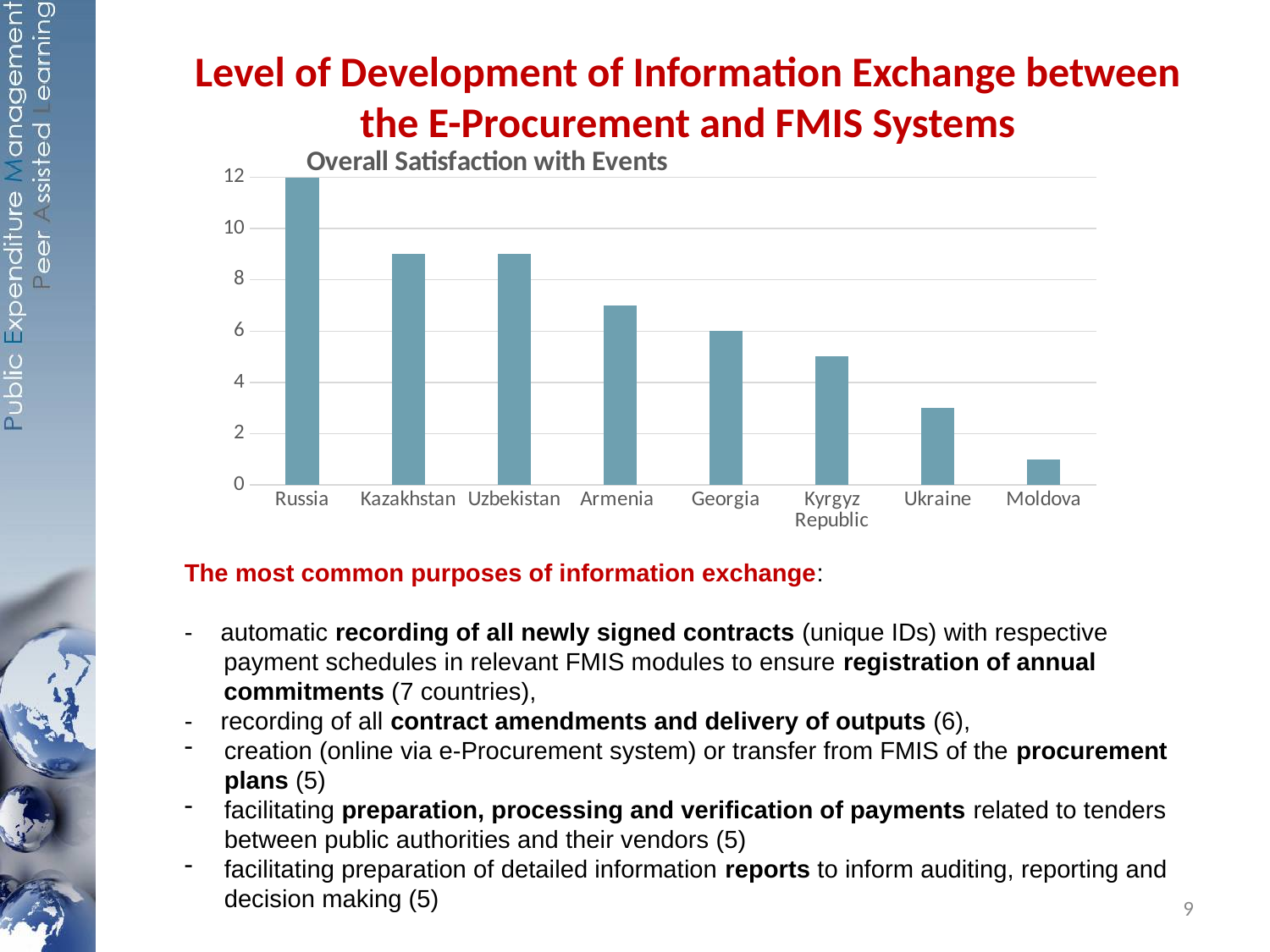
What type of chart is shown on the slide? bar chart Do the values rise or fall moving from left to right along the x axis? fall Is the value for Ukraine greater or less than 4? less Which country has the lowest value in the chart? Moldova Is the value for Kazakhstan greater or less than 8? greater How many countries are shown on the x axis of the chart? 8 What is the title of the chart? Overall Satisfaction with Events What is the value for Georgia? 6 What is the difference between the values for Russia and Georgia? 6 Which has a larger value, Armenia or Ukraine? Armenia Which country has the highest value in the chart? Russia What is the value for Russia? 12